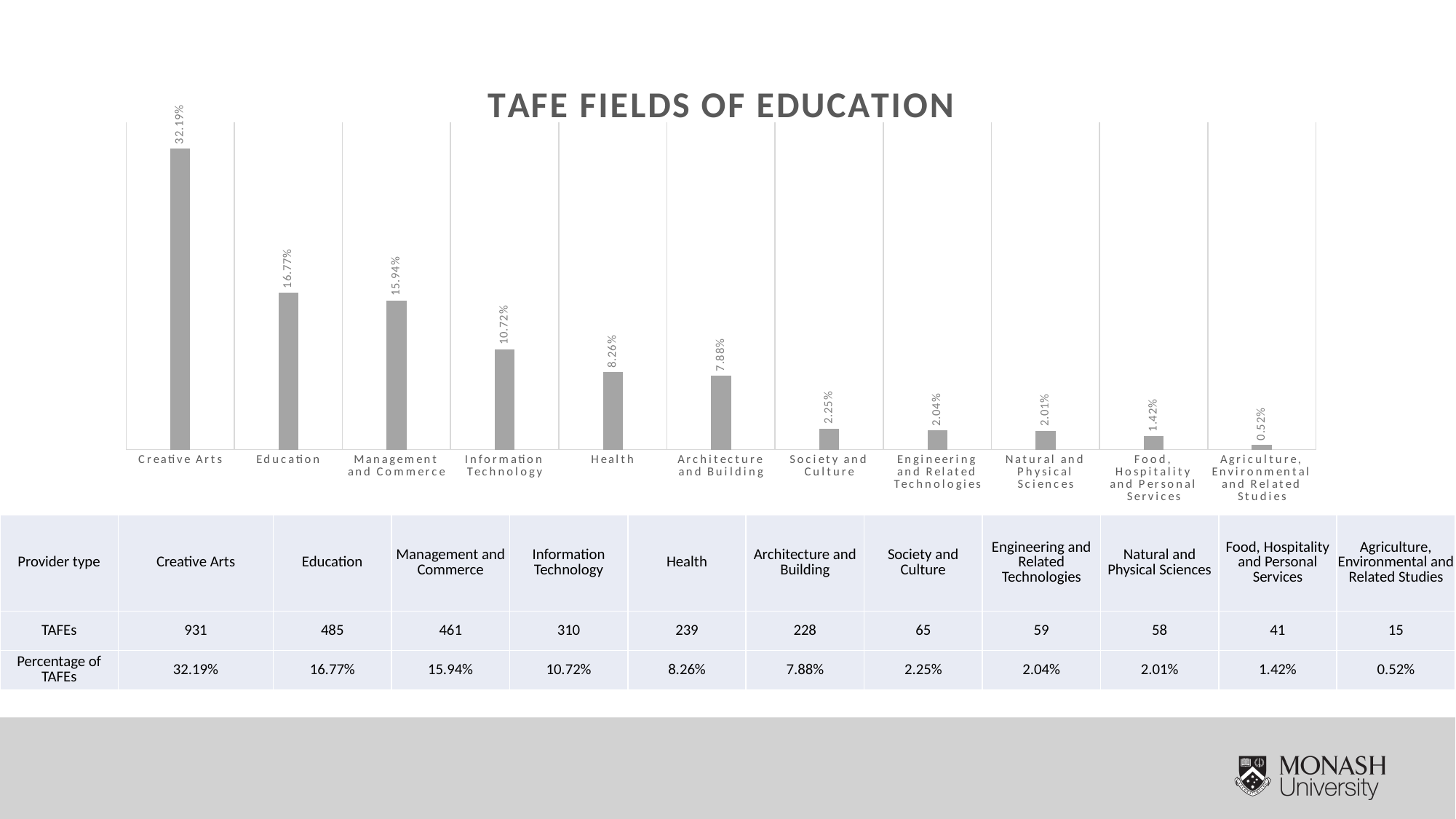
Which is larger, the value for Health or the value for Architecture and Building? Health Which field of education has the lowest value? Agriculture, Environmental and Related Studies What is the difference between the values for Education and Management and Commerce? 0.83% What kind of chart is shown on the slide? Bar chart What is the value for Health? 8.26% What is the title of the chart? TAFE FIELDS OF EDUCATION Which field of education has the highest value? Creative Arts What is the value for Creative Arts? 32.19% Do the values rise or fall from left to right along the x axis? Fall What is the value for Information Technology? 10.72% How many categories are shown on the chart? 11 What is the value for Food, Hospitality and Personal Services? 1.42%